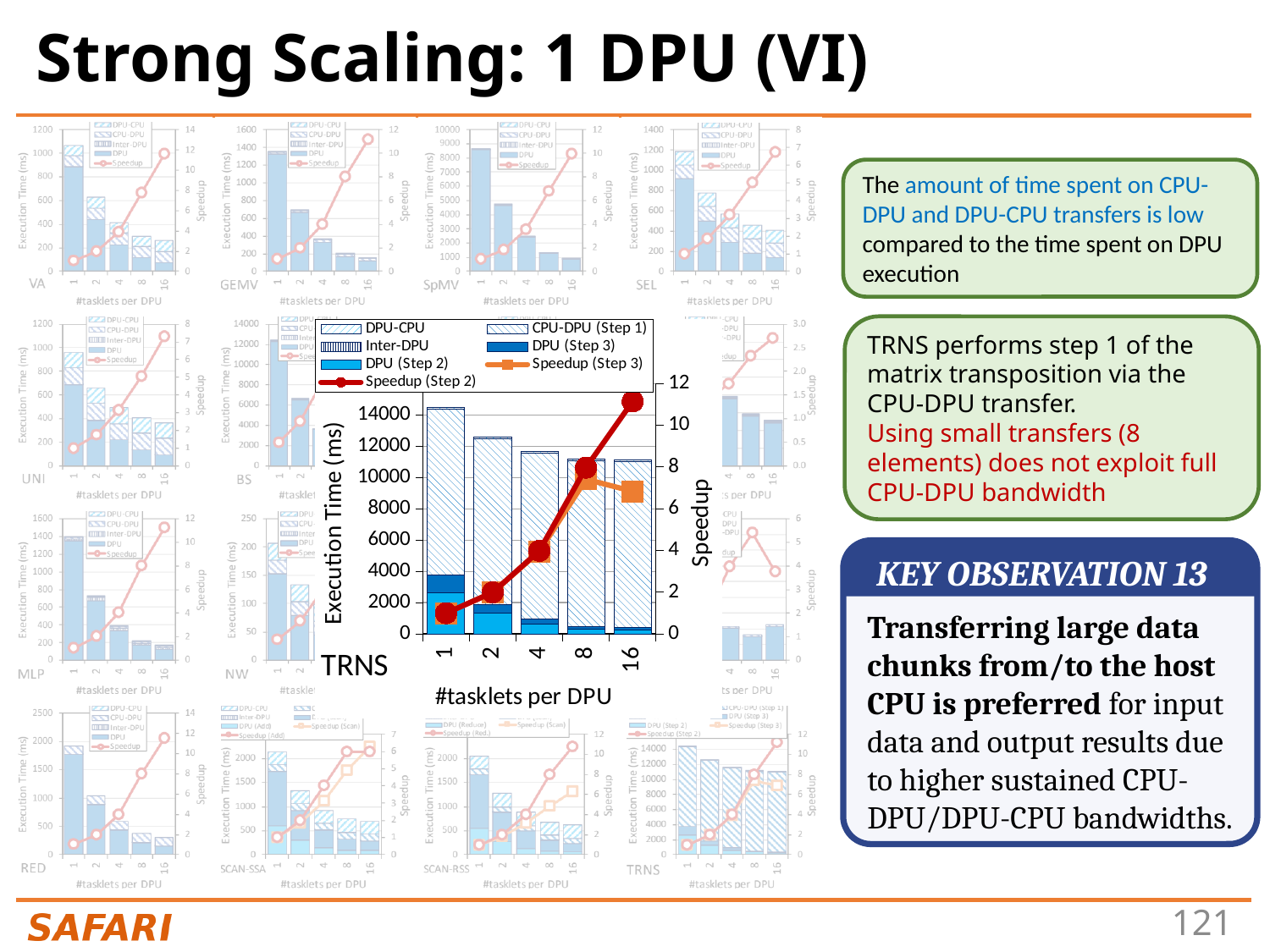
In the enlarged TRNS chart, how many tasklet counts are shown on the x axis? 5 In the enlarged TRNS chart, is the total execution time at 2 tasklets per DPU greater or less than 12000? greater In the enlarged TRNS chart, is the Speedup (Step 2) value at 1 tasklet per DPU greater or less than 2? less In the enlarged TRNS chart, how many series does the legend list? 7 In the enlarged TRNS chart, is the Speedup (Step 2) value at 16 tasklets per DPU greater or less than 10? greater In the enlarged TRNS chart, at 16 tasklets per DPU, which is larger: Speedup (Step 2) or Speedup (Step 3)? Speedup (Step 2) In the enlarged TRNS chart, does the Speedup (Step 2) line rise or fall as the number of tasklets per DPU increases? Rises What is the label of the x axis of the enlarged TRNS chart? #tasklets per DPU What kind of chart is the enlarged TRNS chart? A stacked bar chart combined with line series In the enlarged TRNS chart, at which number of tasklets per DPU is Speedup (Step 2) highest? 16 In the enlarged TRNS chart, at which number of tasklets per DPU is the total execution time bar highest? 1 In the enlarged TRNS chart, does the total execution time bar rise or fall as the number of tasklets per DPU increases? Falls